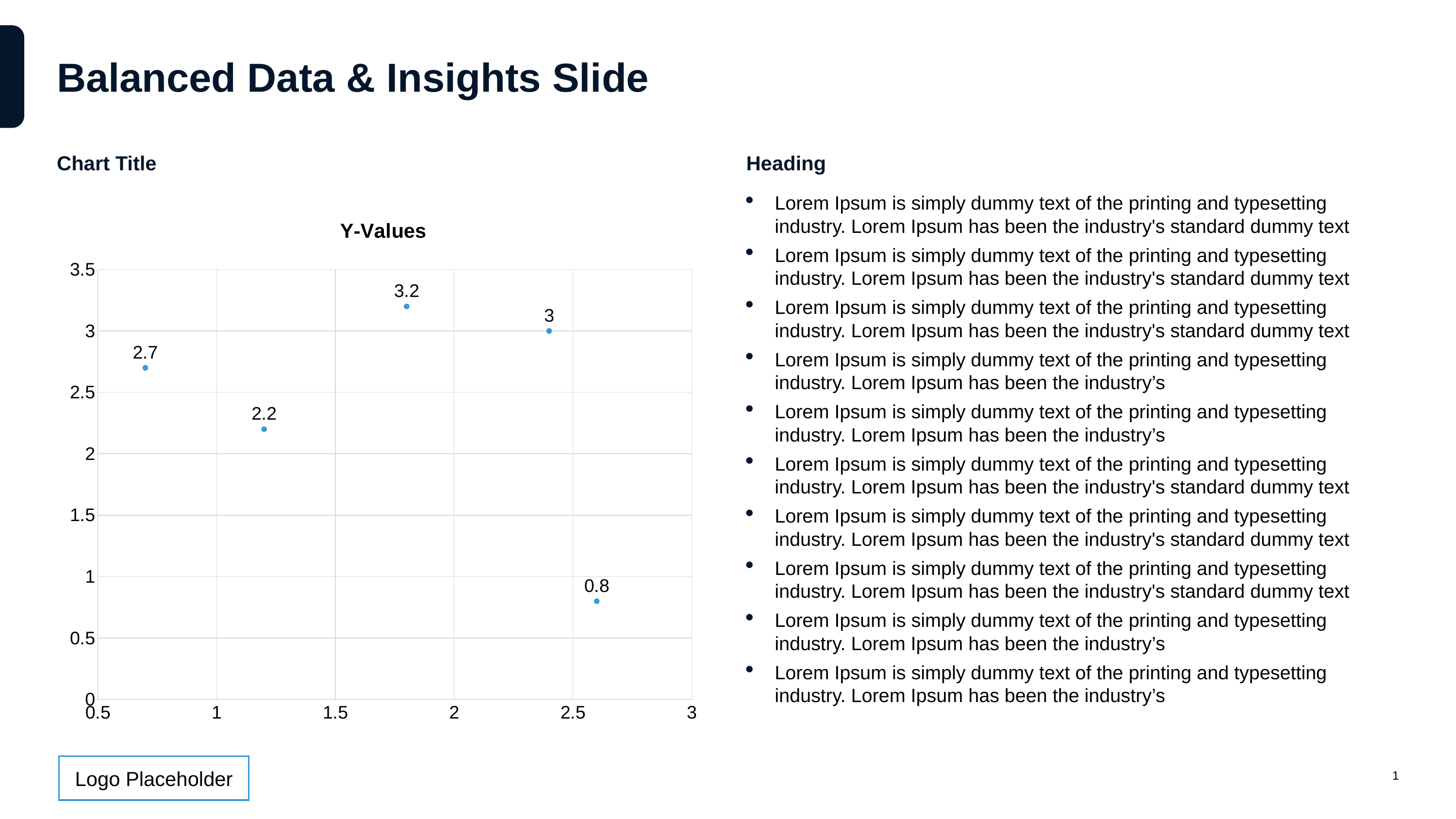
What is the highest labelled value among the plotted points? 3.2 What is the lowest labelled value among the plotted points? 0.8 What is the labelled value of the rightmost point in the chart? 0.8 Is the value of the rightmost point greater or less than 1? less How many data points are plotted in the chart? 5 What is the title shown above the chart's plot area? Y-Values What is the difference between the highest labelled value (3.2) and the lowest labelled value (0.8)? 2.4 Which is larger, the point labelled 3.2 or the point labelled 3? 3.2 What kind of chart is shown on the slide? scatter chart What is the maximum value shown on the vertical axis? 3.5 What is the difference between the points labelled 2.7 and 2.2? 0.5 What is the labelled value of the leftmost point in the chart? 2.7